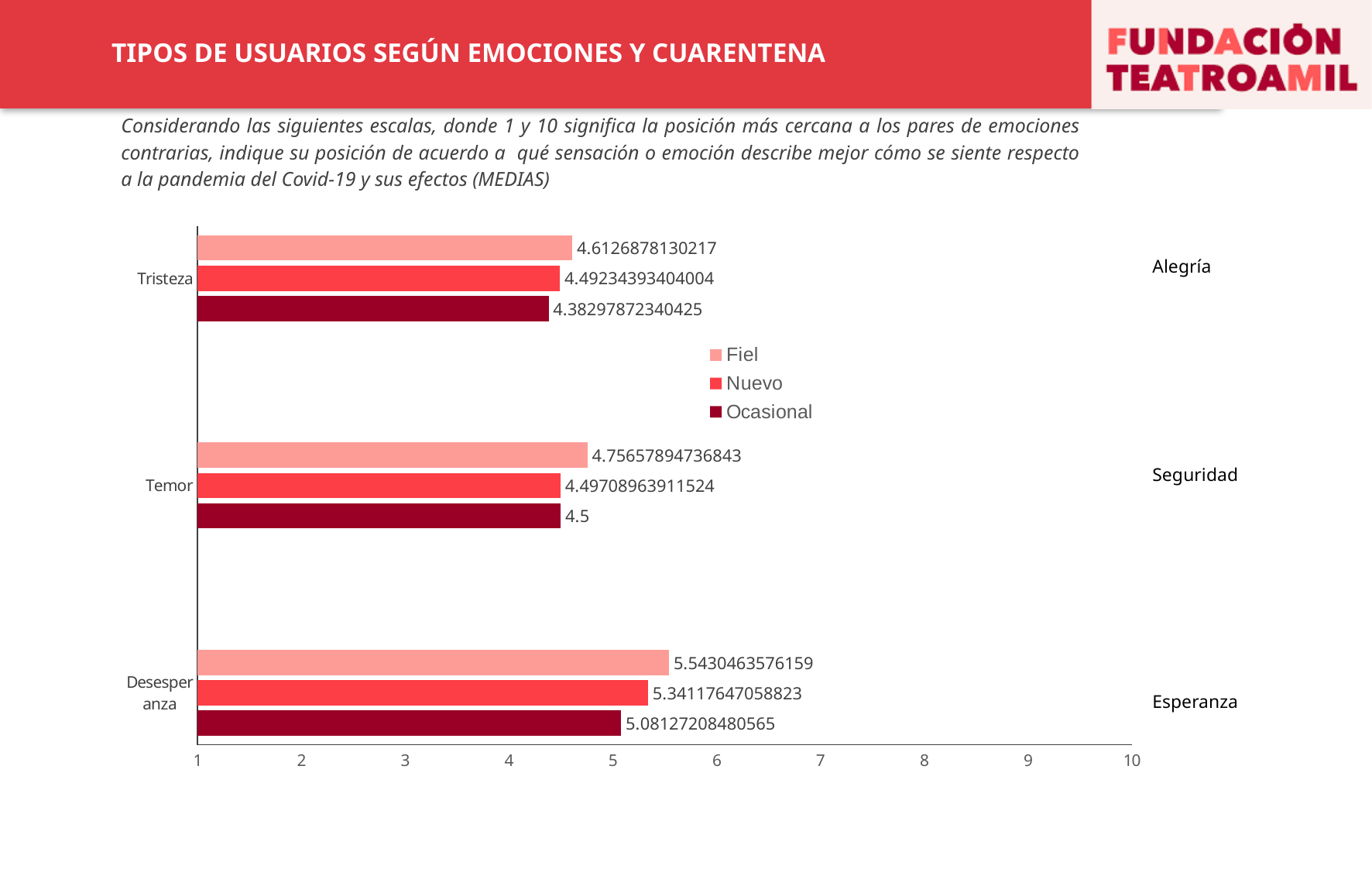
Which category has the highest value for the Fiel series? Desesperanza Which series has the lowest value in the Desesperanza category? Ocasional How many categories are shown on the vertical axis of the chart? 3 What kind of chart is shown on the slide? Bar chart What is the value for Fiel in the Tristeza category? 4.6126878130217 What is the value for Ocasional in the Tristeza category? 4.38297872340425 Which series is shown in the darkest red colour in the legend? Ocasional How many series does the legend list? 3 Is the value for Fiel in the Desesperanza category greater or less than 5? greater What is the value for Nuevo in the Desesperanza category? 5.34117647058823 Which is larger: the Fiel value for Temor or the Fiel value for Tristeza? Fiel value for Temor What is the value for Ocasional in the Temor category? 4.5